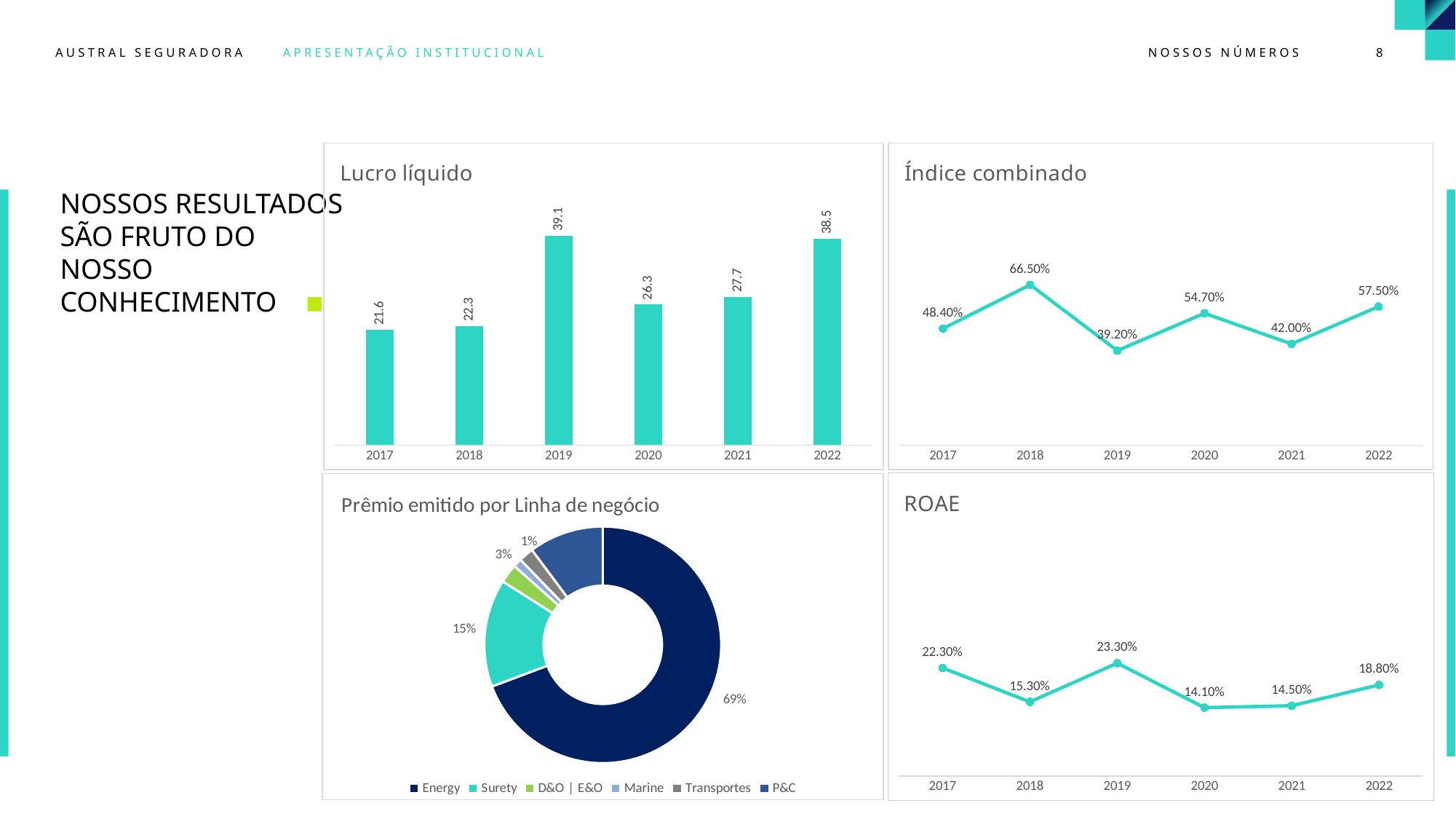
In the Índice combinado chart, what is the value for 2018? 66.50% How many series does the legend of the Prêmio emitido por Linha de negócio chart list? 6 In the Lucro líquido chart, what is the value for 2019? 39.1 In the Lucro líquido chart, which year has the lowest value? 2017 In the ROAE chart, what is the difference between the 2017 and 2020 values? 8.20% In the ROAE chart, what is the value for 2019? 23.30% In the Índice combinado chart, which year has the lowest value? 2019 What kind of chart is the Lucro líquido chart? bar chart In the Índice combinado chart, is the value for 2020 larger or smaller than the value for 2022? smaller How many years are plotted in the ROAE chart? 6 In the Prêmio emitido por Linha de negócio chart, what share does Energy have? 69% In the Lucro líquido chart, what is the difference between the 2022 and 2021 values? 10.8